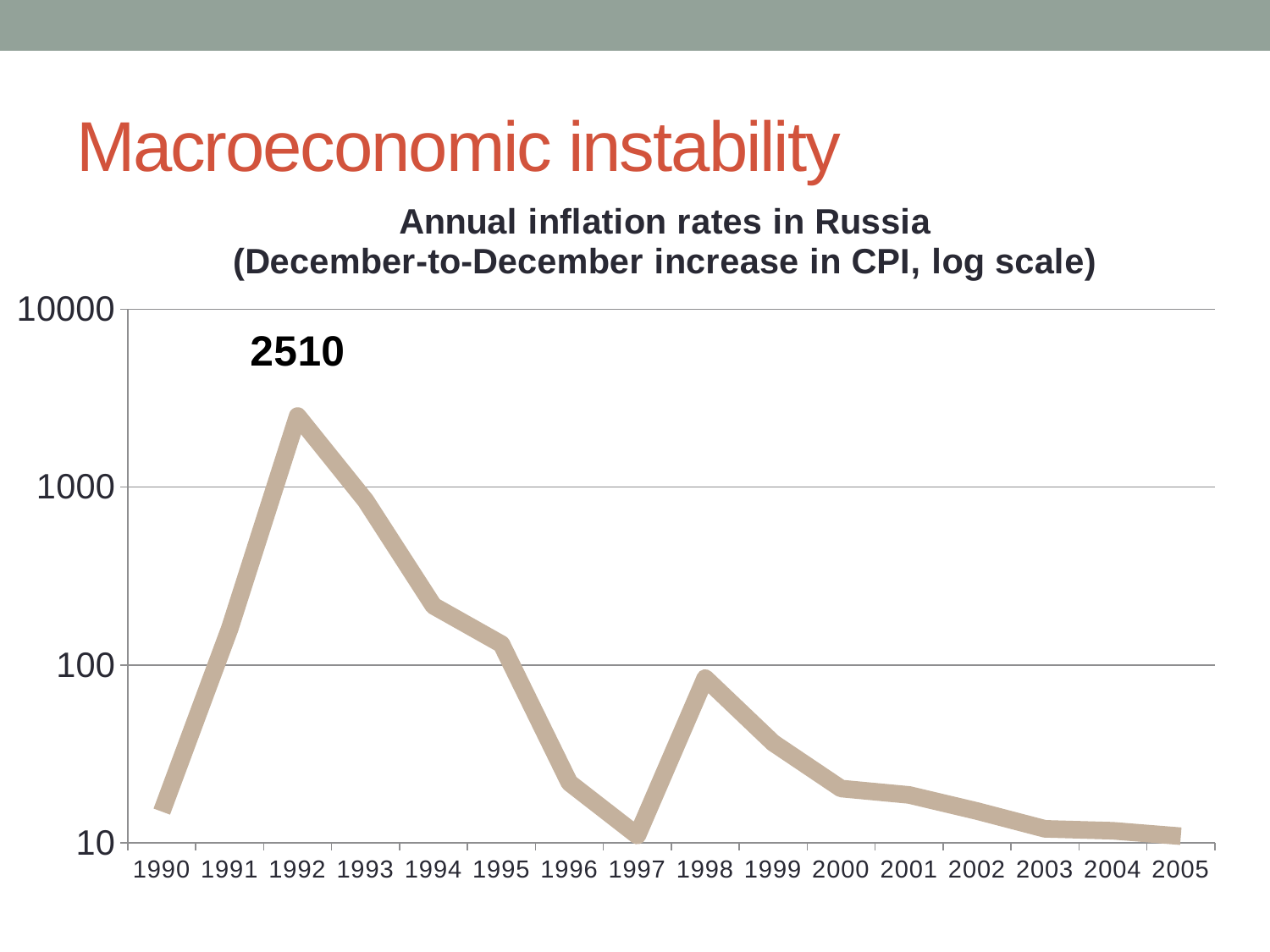
Do the values rise or fall from 1990 to 1992? rise How many years are plotted on the x axis? 16 Is the value for 1993 greater or less than 1000? less What is the annual inflation rate shown for 1992? 2510 What type of chart is shown on the slide? line chart Is the value for 1994 greater or less than 100? greater Which year has the highest annual inflation rate? 1992 Is the value for 1999 greater or less than 100? less What is the title of the chart? Annual inflation rates in Russia (December-to-December increase in CPI, log scale) Do the values rise or fall from 1992 to 1997? fall Which year has the larger inflation rate, 1994 or 1996? 1994